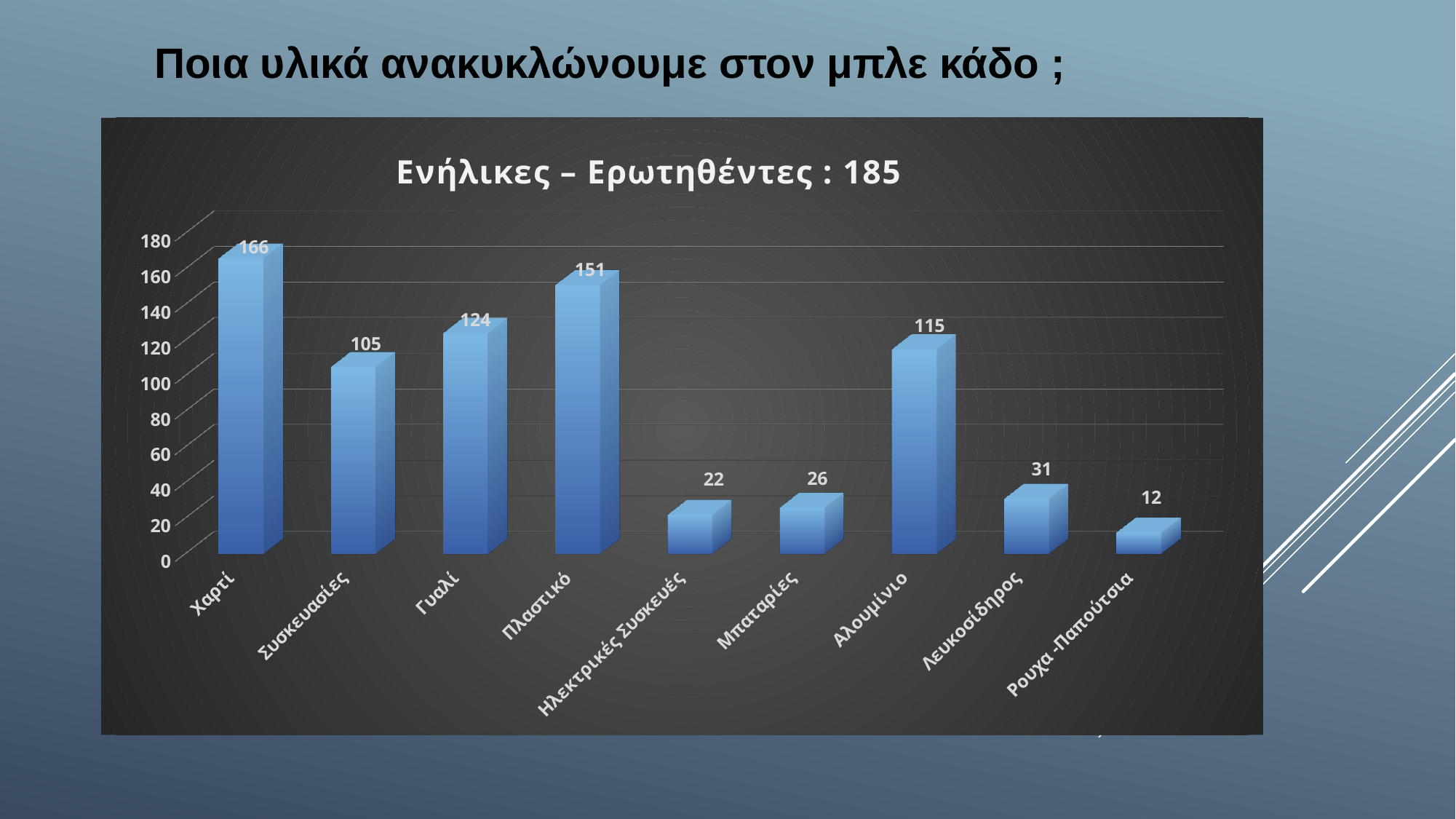
What is the difference between the values for Χαρτί and Πλαστικό? 15 Which is larger, the value for Γυαλί or the value for Αλουμίνιο? Γυαλί How many categories are shown on the x axis? 9 What kind of chart is shown on the slide? bar chart Which category has the lowest value? Ρούχα-Παπούτσια Which category has the highest value? Χαρτί What is the title of the chart? Ενήλικες – Ερωτηθέντες : 185 Is the value for Συσκευασίες greater or less than 100? greater What is the difference between the values for Λευκοσίδηρος and Μπαταρίες? 5 What is the value for Ρούχα-Παπούτσια? 12 What is the value for Χαρτί? 166 What is the value for Αλουμίνιο? 115